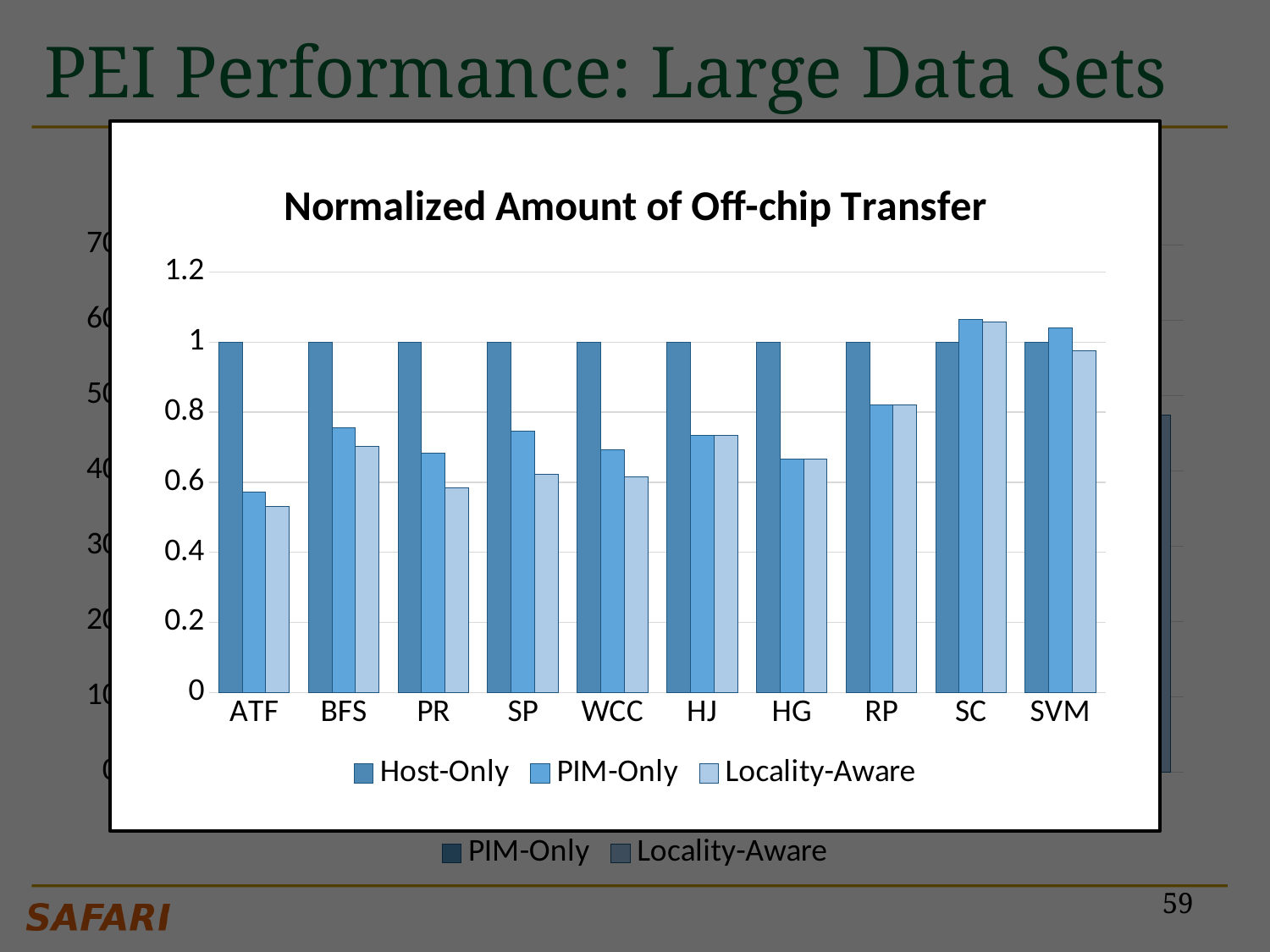
In the "Normalized Amount of Off-chip Transfer" chart, which series is listed first in the legend? Host-Only In the "Normalized Amount of Off-chip Transfer" chart, how many series does the legend list? 3 In the "Normalized Amount of Off-chip Transfer" chart, is the PIM-Only value for SC greater or less than 1? greater In the "Normalized Amount of Off-chip Transfer" chart, what kind of chart is shown? bar chart In the "Normalized Amount of Off-chip Transfer" chart, what is the Host-Only value for ATF? 1 In the "Normalized Amount of Off-chip Transfer" chart, which category has the lowest Locality-Aware value? ATF In the "Normalized Amount of Off-chip Transfer" chart, how many categories are shown on the x axis? 10 In the "Normalized Amount of Off-chip Transfer" chart, which category has the highest PIM-Only value? SC In the "Normalized Amount of Off-chip Transfer" chart, is the Locality-Aware value for ATF greater or less than 0.6? less In the "Normalized Amount of Off-chip Transfer" chart, which is larger for SVM: the PIM-Only value or the Locality-Aware value? PIM-Only